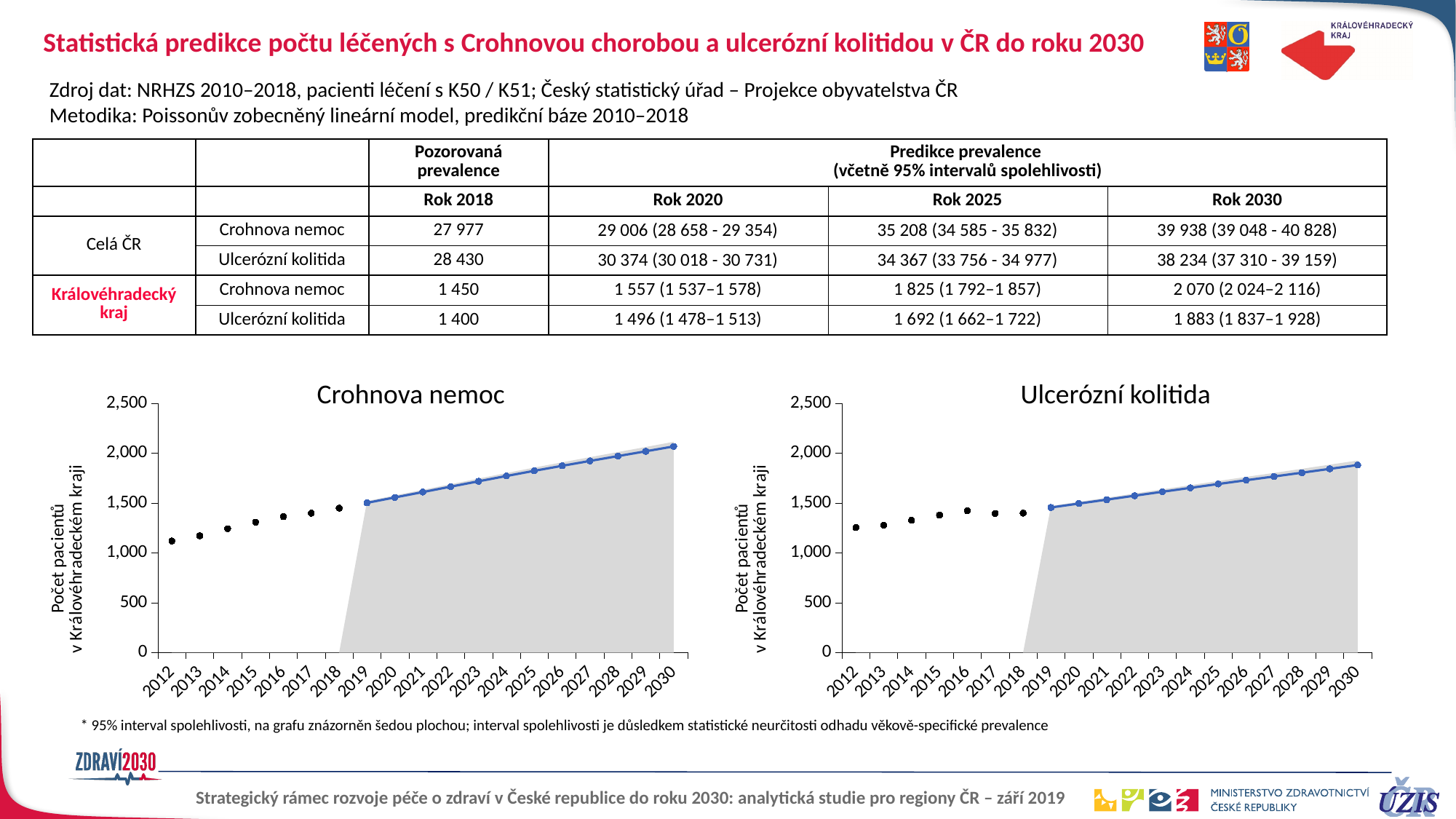
On the Crohnova nemoc chart, is the value for 2012 greater or less than 1,000? greater How many years are shown on the x axis of the Crohnova nemoc chart? 19 On the Ulcerózní kolitida chart, is the value for 2019 greater or less than 1,500? less On the Ulcerózní kolitida chart, which year has the lowest value? 2012 On the Ulcerózní kolitida chart, is the value for 2030 greater or less than 2,000? less On the Crohnova nemoc chart, which year has the highest value? 2030 What kind of chart is the Ulcerózní kolitida chart? line chart On the Crohnova nemoc chart, do the values rise or fall from 2012 to 2030? rise What is the y-axis label of the Ulcerózní kolitida chart? Počet pacientů v Královéhradeckém kraji